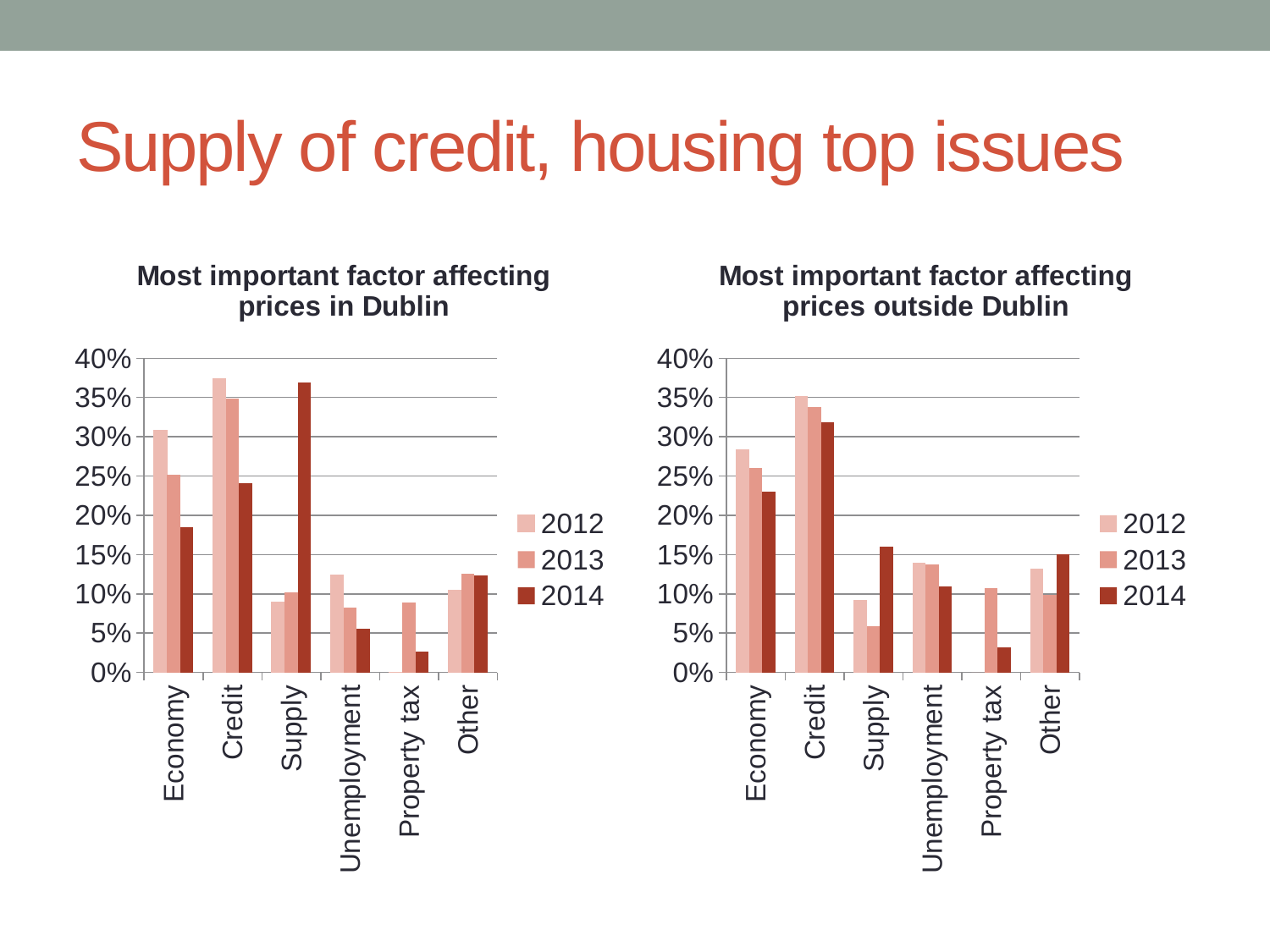
In the 'Most important factor affecting prices in Dublin' chart, is the value for Supply in 2014 greater or less than 35%? greater In the 'Most important factor affecting prices in Dublin' chart, which is larger for 2012: Credit or Economy? Credit In the 'Most important factor affecting prices outside Dublin' chart, do the values for Credit rise or fall from 2012 to 2014? fall What are the legend entries in the 'Most important factor affecting prices outside Dublin' chart? 2012, 2013, 2014 In the 'Most important factor affecting prices outside Dublin' chart, which factor has the highest value for 2012? Credit In the 'Most important factor affecting prices in Dublin' chart, how many factor categories are shown on the x axis? 6 In the 'Most important factor affecting prices outside Dublin' chart, which factor has the lowest value for 2014? Property tax In the 'Most important factor affecting prices in Dublin' chart, which factor has the highest value for 2014? Supply In the 'Most important factor affecting prices in Dublin' chart, how many series does the legend list? 3 What kind of chart is the 'Most important factor affecting prices in Dublin' chart? Bar chart In the 'Most important factor affecting prices outside Dublin' chart, is the value for Economy in 2014 greater or less than 20%? greater In the 'Most important factor affecting prices in Dublin' chart, do the values for Economy rise or fall from 2012 to 2014? fall